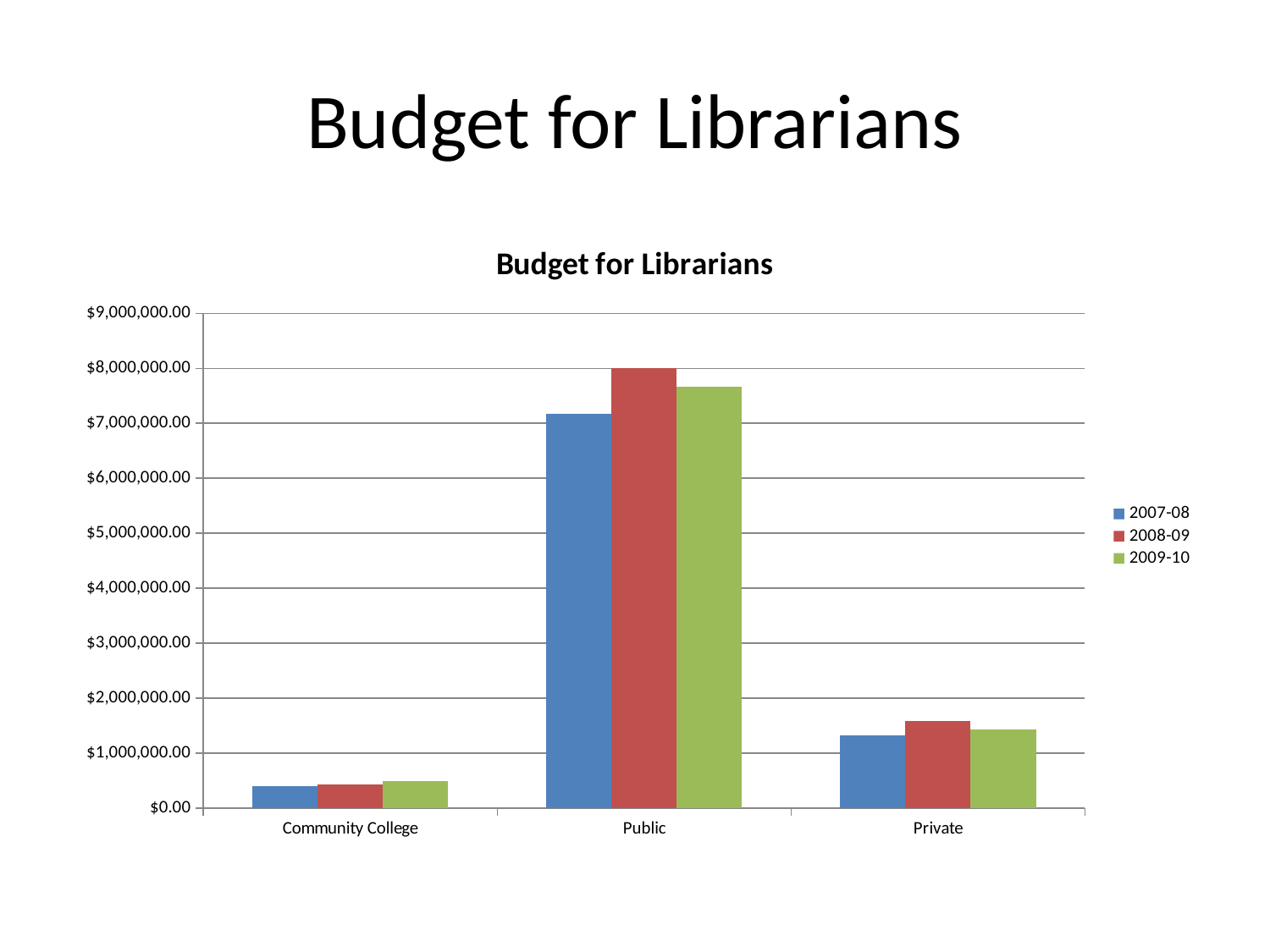
Do the values for Community College rise or fall from 2007-08 to 2009-10? rise Is the 2009-10 value for Community College greater or less than $1,000,000.00? less For Private, which is larger: the 2007-08 value or the 2008-09 value? 2008-09 Which category has the highest budget for librarians? Public How many categories are shown on the x axis? 3 Is the 2007-08 value for Public greater or less than $7,000,000.00? greater How many series does the legend list? 3 What kind of chart is shown on the slide? Bar chart What are the three series listed in the legend? 2007-08, 2008-09, 2009-10 Which category has the lowest budget for librarians? Community College For Public, which is larger: the 2007-08 value or the 2009-10 value? 2009-10 Is the 2008-09 value for Private greater or less than $2,000,000.00? less